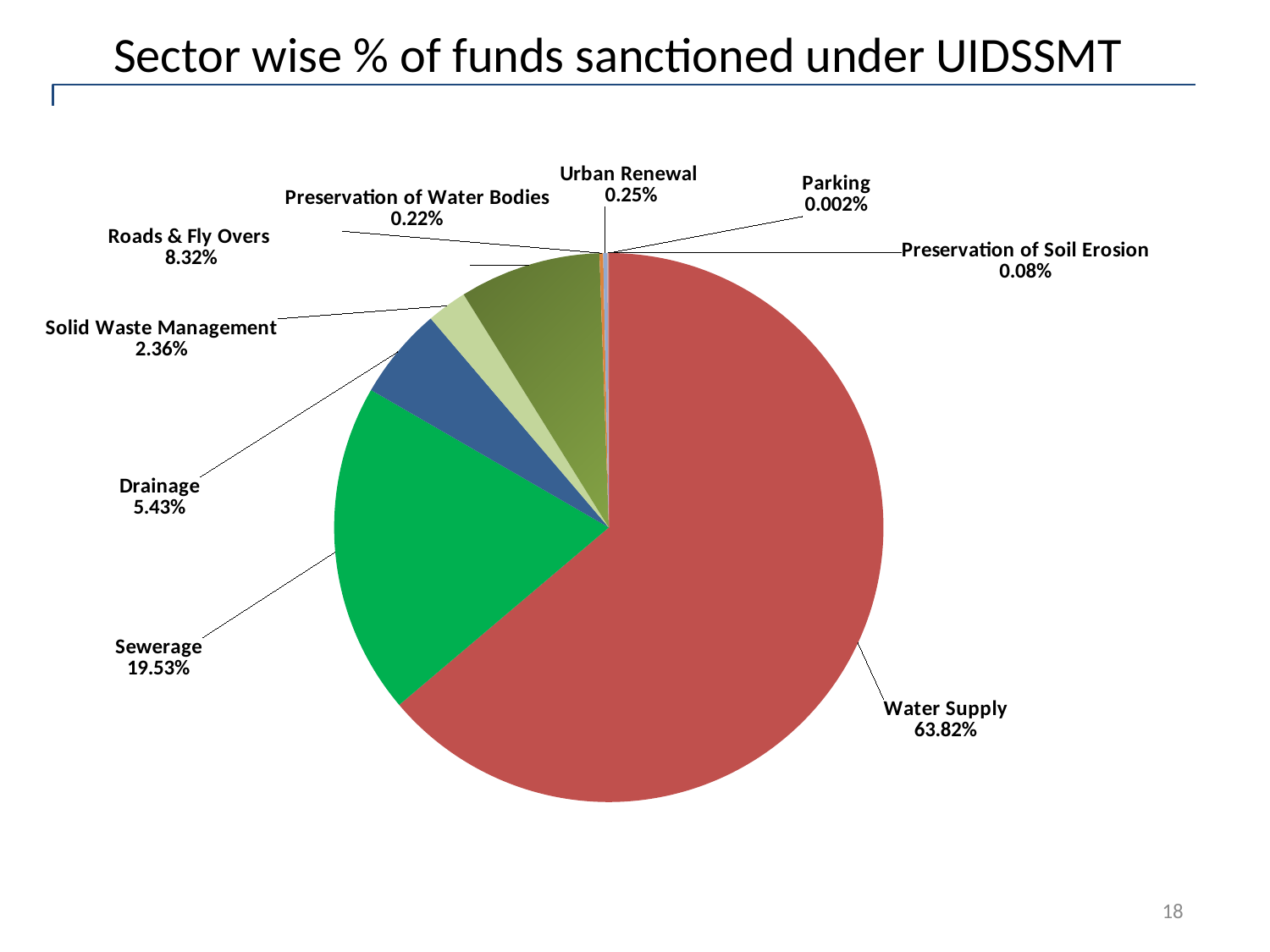
What is the title of the chart on the slide? Sector wise % of funds sanctioned under UIDSSMT What is the share shown for Roads & Fly Overs? 8.32% What type of chart is shown on the slide? Pie chart What percentage of funds sanctioned under UIDSSMT went to Water Supply? 63.82% How many sectors are shown in the pie chart? 9 What percentage of funds was sanctioned for Sewerage? 19.53% What percentage is shown for Parking? 0.002% What percentage is shown for Drainage? 5.43% Which received a larger share of funds, Drainage or Solid Waste Management? Drainage Which sector received the smallest share of funds? Parking Which sector received the largest share of funds sanctioned under UIDSSMT? Water Supply What is the difference in percentage points between Water Supply and Sewerage? 44.29